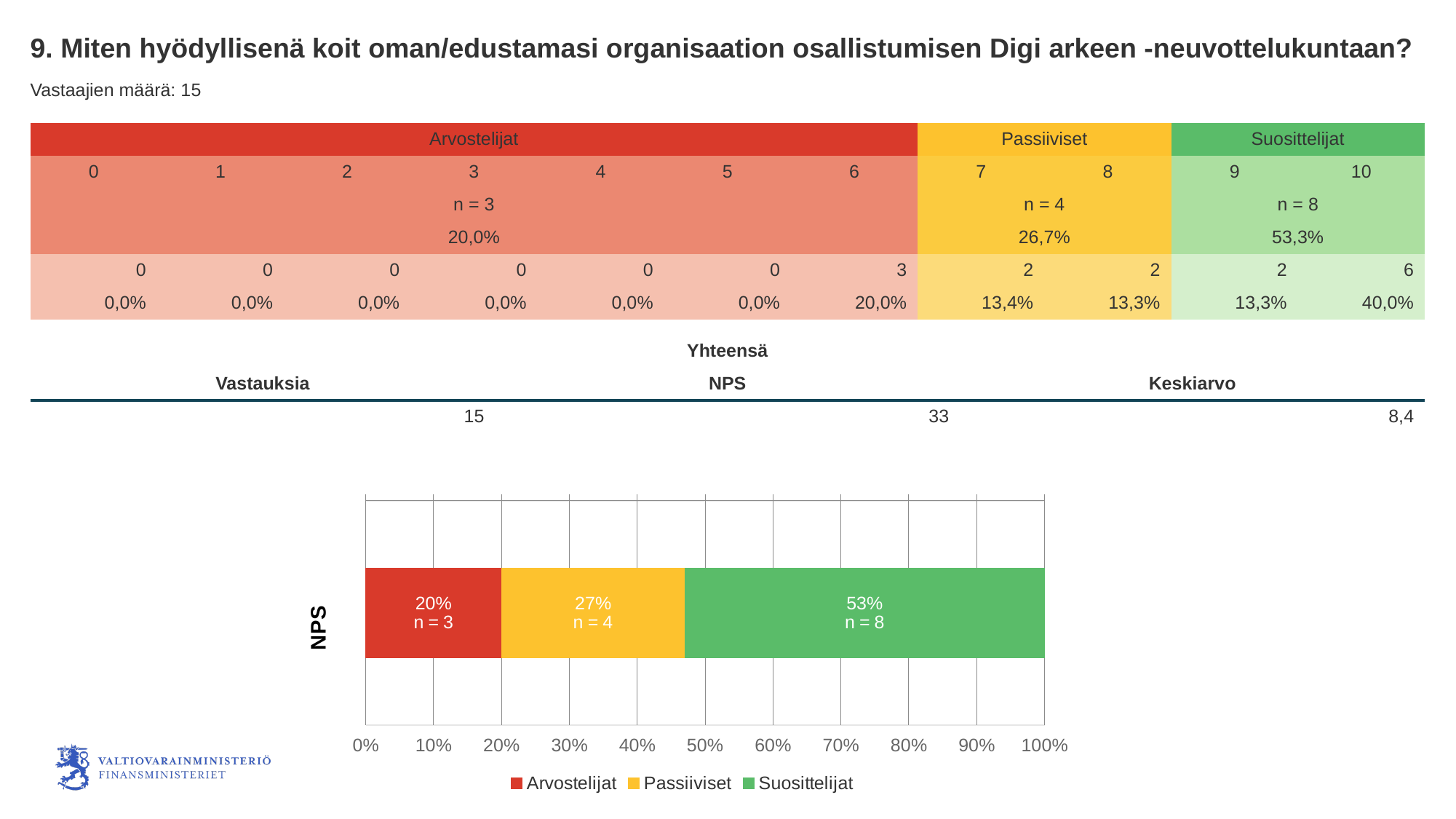
Which segment of the NPS bar is the largest? Suosittelijat How many respondents (n) are in the Suosittelijat segment of the bar chart? n = 8 What percentage does the Passiiviset segment show in the NPS bar chart? 27% What kind of chart is shown at the bottom of the slide? Stacked bar chart What percentage does the Arvostelijat segment show in the NPS bar chart? 20% What is the total of the three segments in the NPS stacked bar? 100% Which segment of the NPS bar is the smallest? Arvostelijat How many series does the legend of the bar chart list? 3 What percentage does the Suosittelijat segment show in the NPS bar chart? 53% What colour is the Suosittelijat series in the bar chart? Green What is the difference in percentage points between the Suosittelijat and Arvostelijat segments in the bar chart? 33 Which is larger in the bar chart, the Passiiviset segment or the Arvostelijat segment? Passiiviset